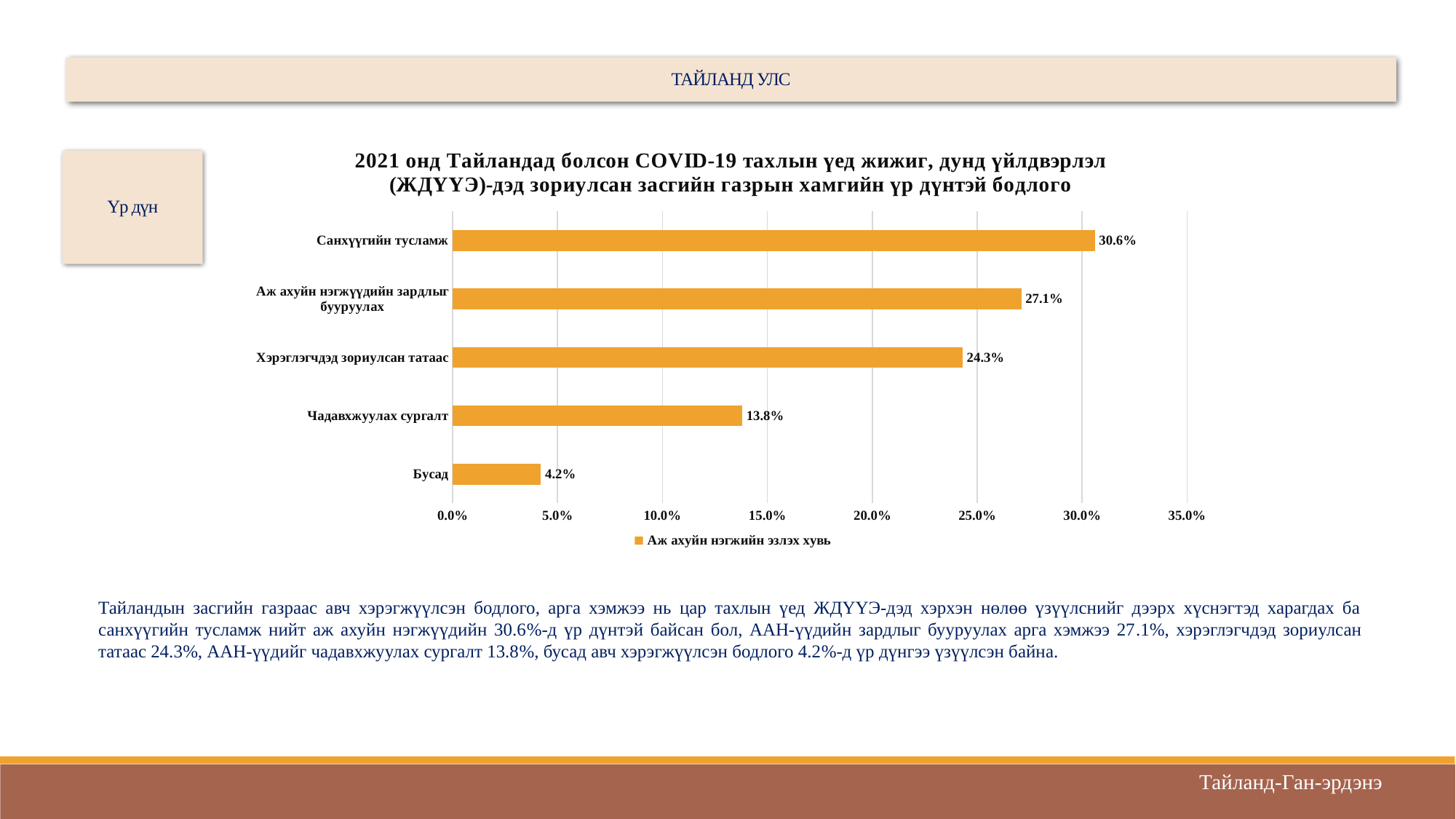
Which category has the lowest value? Бусад How many categories are shown in the chart? 5 What is the difference between Санхүүгийн тусламж and Аж ахуйн нэгжүүдийн зардлыг бууруулах? 3.5% What kind of chart is shown on the slide? Bar chart What is the value for Чадавхжуулах сургалт? 13.8% What is the value for Бусад? 4.2% What series name does the legend show? Аж ахуйн нэгжийн эзлэх хувь What is the value for Санхүүгийн тусламж? 30.6% Which category has the highest value? Санхүүгийн тусламж Which is larger, Хэрэглэгчдэд зориулсан татаас or Чадавхжуулах сургалт? Хэрэглэгчдэд зориулсан татаас Is the value for Аж ахуйн нэгжүүдийн зардлыг бууруулах greater or less than 25.0%? greater What is the difference between Хэрэглэгчдэд зориулсан татаас and Чадавхжуулах сургалт? 10.5%